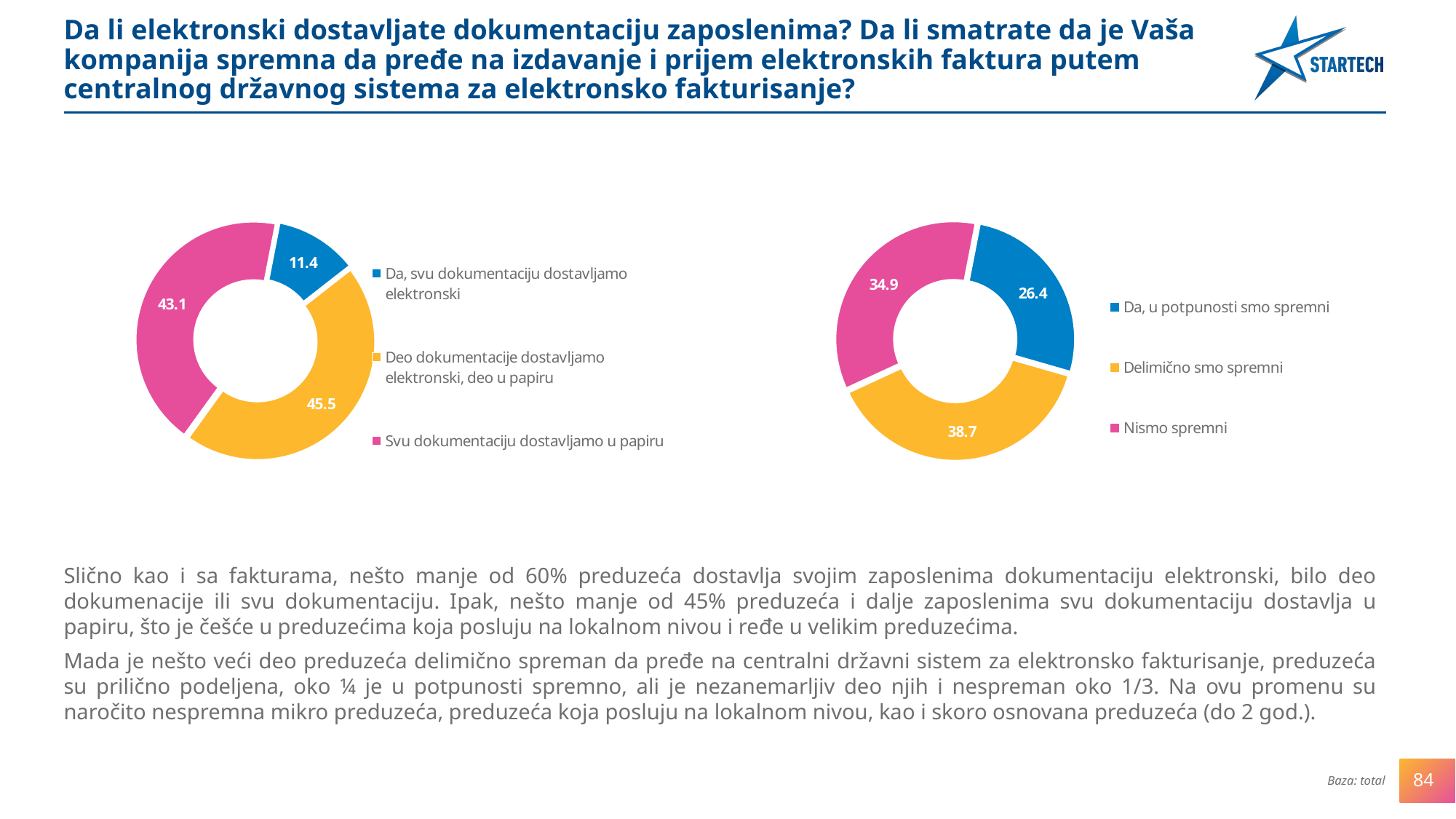
In the right chart, what is the value for "Nismo spremni"? 34.9 In the left chart, what is the value for "Da, svu dokumentaciju dostavljamo elektronski"? 11.4 In the right chart, which category has the smallest slice? Da, u potpunosti smo spremni In the left chart, which category has the largest slice? Deo dokumentacije dostavljamo elektronski, deo u papiru How many categories does the right chart show? 3 In the left chart, which category has the smallest slice? Da, svu dokumentaciju dostavljamo elektronski In the left chart, what is the value for "Svu dokumentaciju dostavljamo u papiru"? 43.1 In the right chart, what is the difference between the values for "Delimično smo spremni" and "Nismo spremni"? 3.8 In the left chart, what is the difference between the values for "Deo dokumentacije dostavljamo elektronski, deo u papiru" and "Da, svu dokumentaciju dostavljamo elektronski"? 34.1 In the right chart, what is the value for "Delimično smo spremni"? 38.7 In the right chart, which is larger: "Delimično smo spremni" or "Da, u potpunosti smo spremni"? Delimično smo spremni What type of chart is the left chart? Doughnut chart